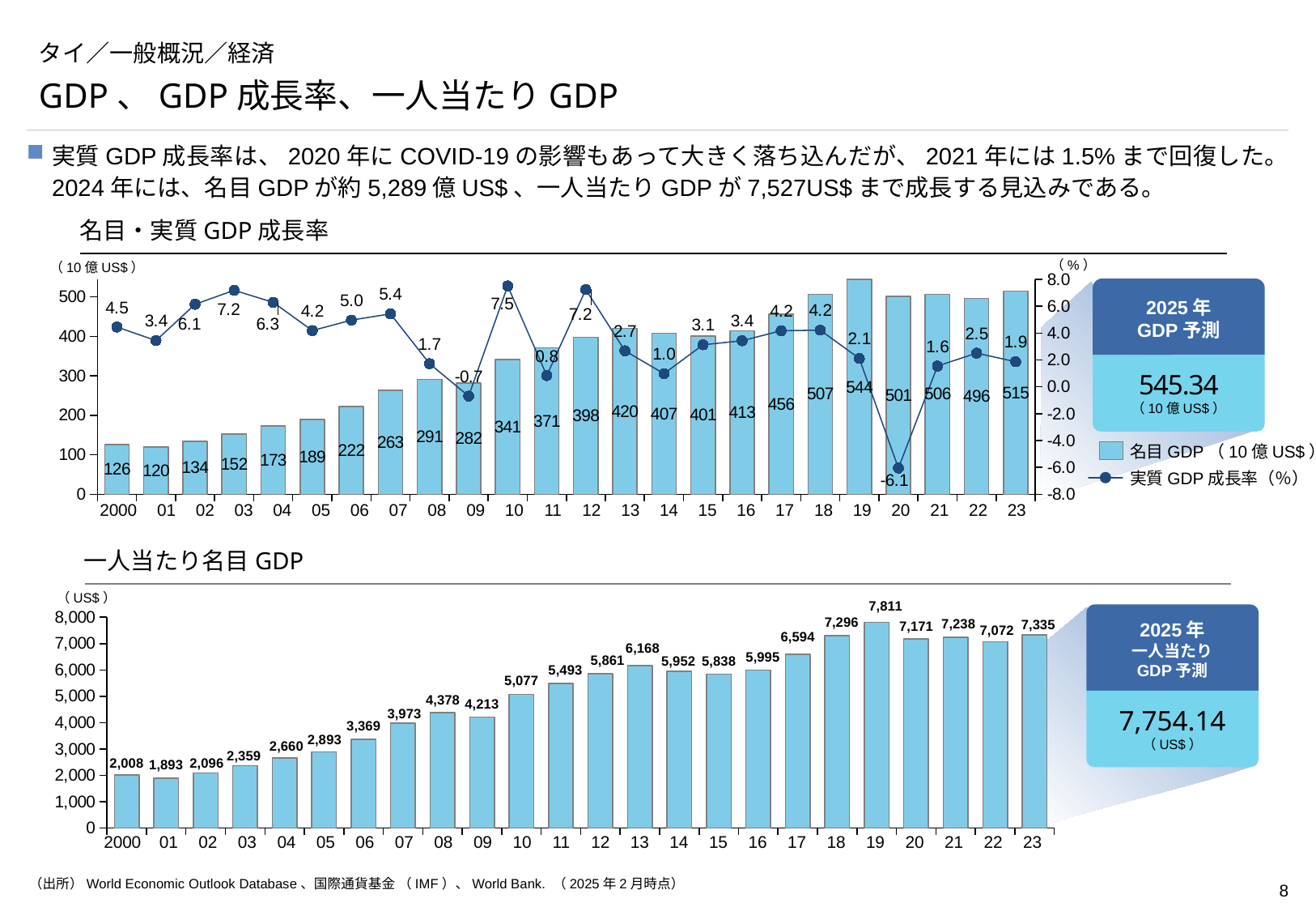
What kind of chart is the 一人当たり名目GDP chart? Bar chart In the 名目・実質GDP成長率 chart, which year has the highest 名目GDP? 19 In the 名目・実質GDP成長率 chart, what is the 実質GDP成長率 for 2020? -6.1 In the 一人当たり名目GDP chart, what is the value for 2019? 7,811 How many series does the legend of the 名目・実質GDP成長率 chart list? 2 In the 名目・実質GDP成長率 chart, what is the 名目GDP value for 2019? 544 In the 一人当たり名目GDP chart, what is the difference between the 2023 value and the 2022 value? 263 In the 一人当たり名目GDP chart, which year has the lowest value? 01 In the 名目・実質GDP成長率 chart, which year has the lowest 実質GDP成長率? 20 How many years are plotted in the 一人当たり名目GDP chart? 24 In the 名目・実質GDP成長率 chart, what is the difference in 名目GDP between 2023 and 2000? 389 In the 名目・実質GDP成長率 chart, is the 実質GDP成長率 higher in 2010 or in 2011? 2010